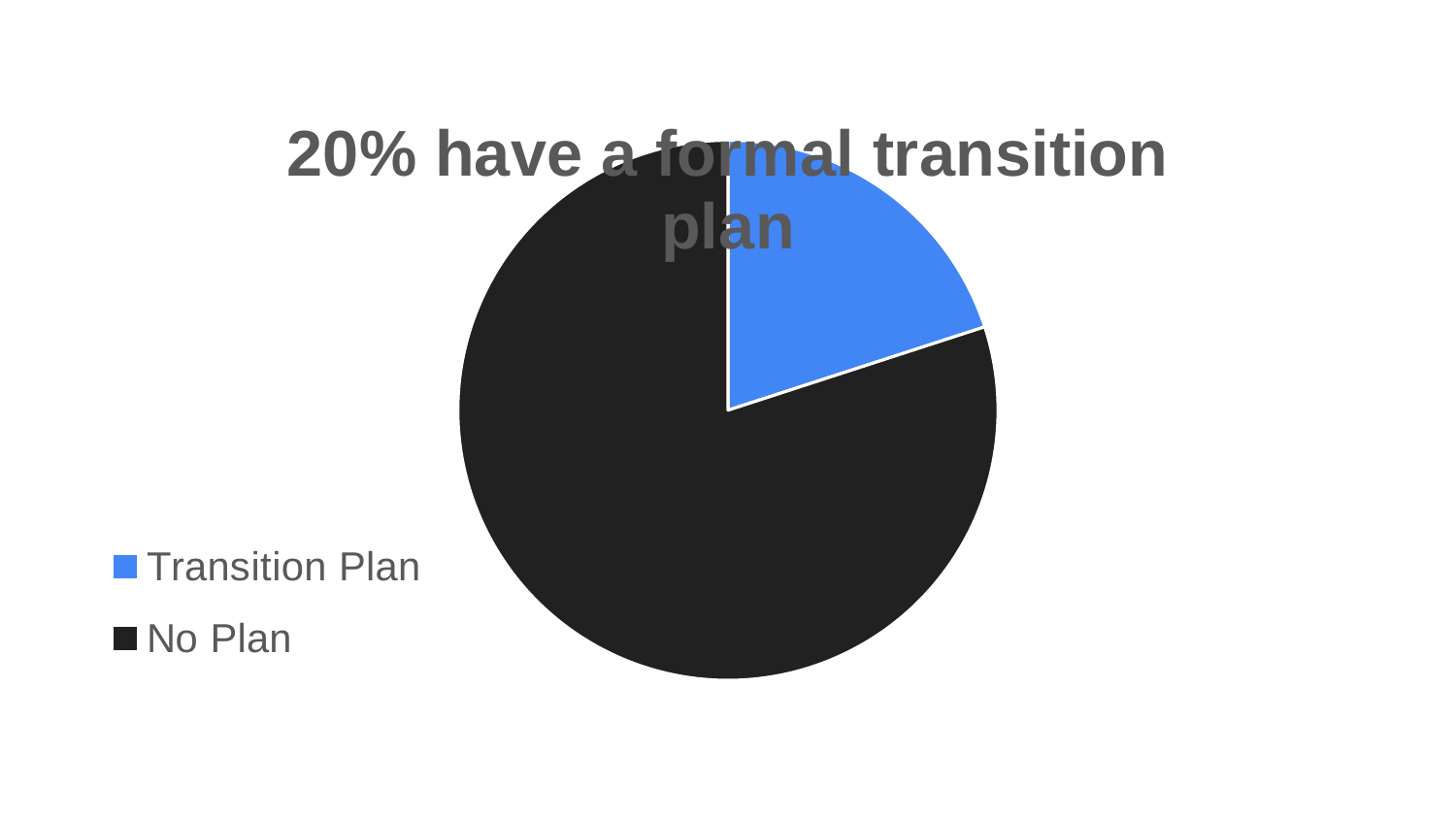
What share of the pie does the Transition Plan slice represent? 20% How many slices does the pie chart have? 2 What is the title of the chart? 20% have a formal transition plan Which is larger, the Transition Plan slice or the No Plan slice? No Plan Which slice is the smallest in the pie chart? Transition Plan How many entries does the legend list? 2 Which slice is the largest in the pie chart? No Plan What kind of chart is shown on the slide? pie chart What share of the pie does the No Plan slice represent? 80% What colour is the Transition Plan slice? blue